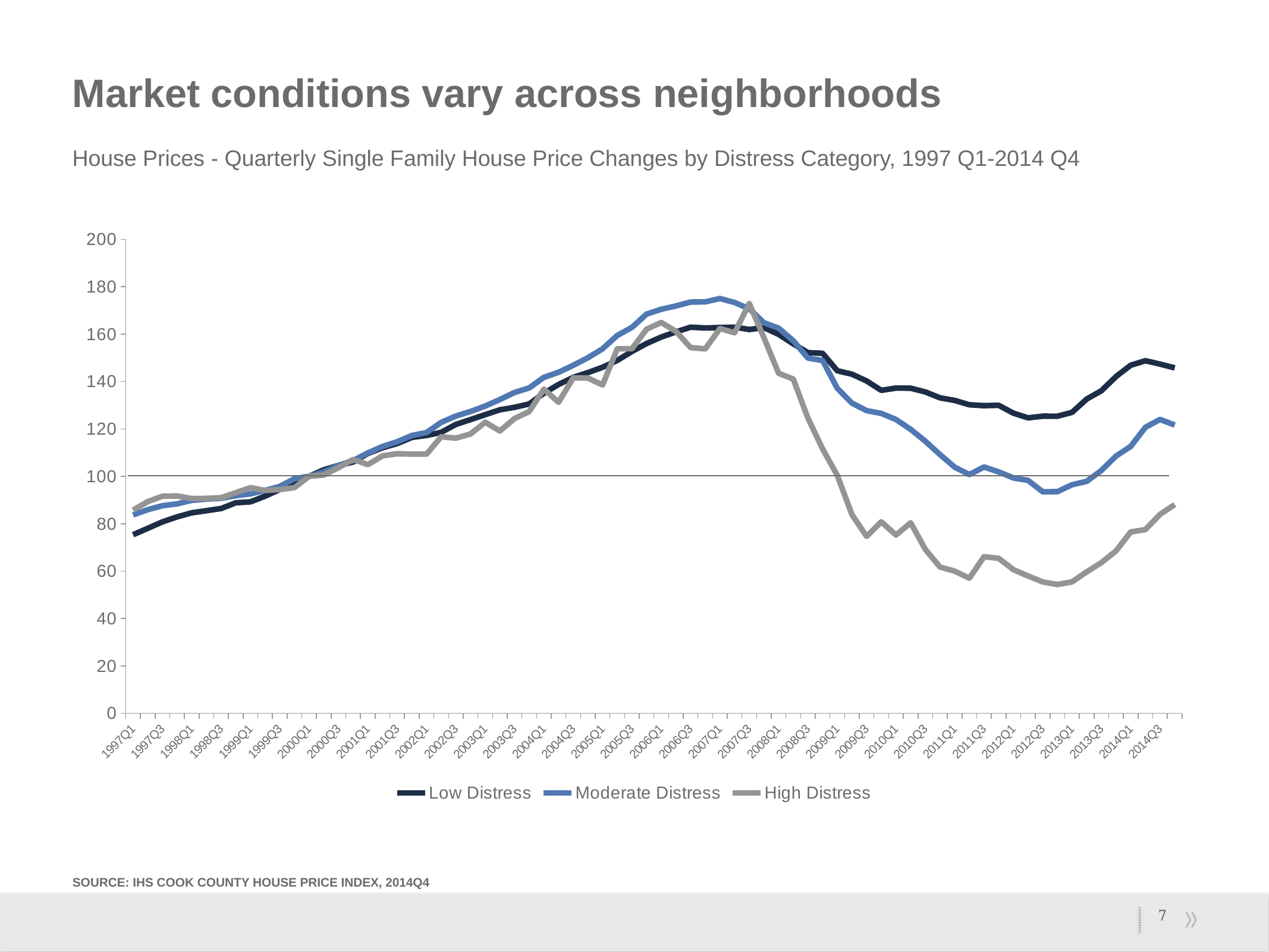
What are the three series named in the legend? Low Distress, Moderate Distress, High Distress How many series does the legend list? 3 Is the value for Moderate Distress at 2007Q1 greater or less than 160? greater Which series has the lowest value at 2011Q1? High Distress Does the High Distress line rise or fall between 2008Q1 and 2009Q3? Fall What kind of chart is shown on the slide? Line chart Is the value for High Distress at 2013Q1 greater or less than 60? less What is the chart's subtitle describing the data? House Prices - Quarterly Single Family House Price Changes by Distress Category, 1997 Q1-2014 Q4 Is the value for Low Distress at 2014Q1 greater or less than 140? greater At 2010Q1, which series has the higher value, Moderate Distress or High Distress? Moderate Distress At 2014Q3, which series has the higher value, Low Distress or High Distress? Low Distress